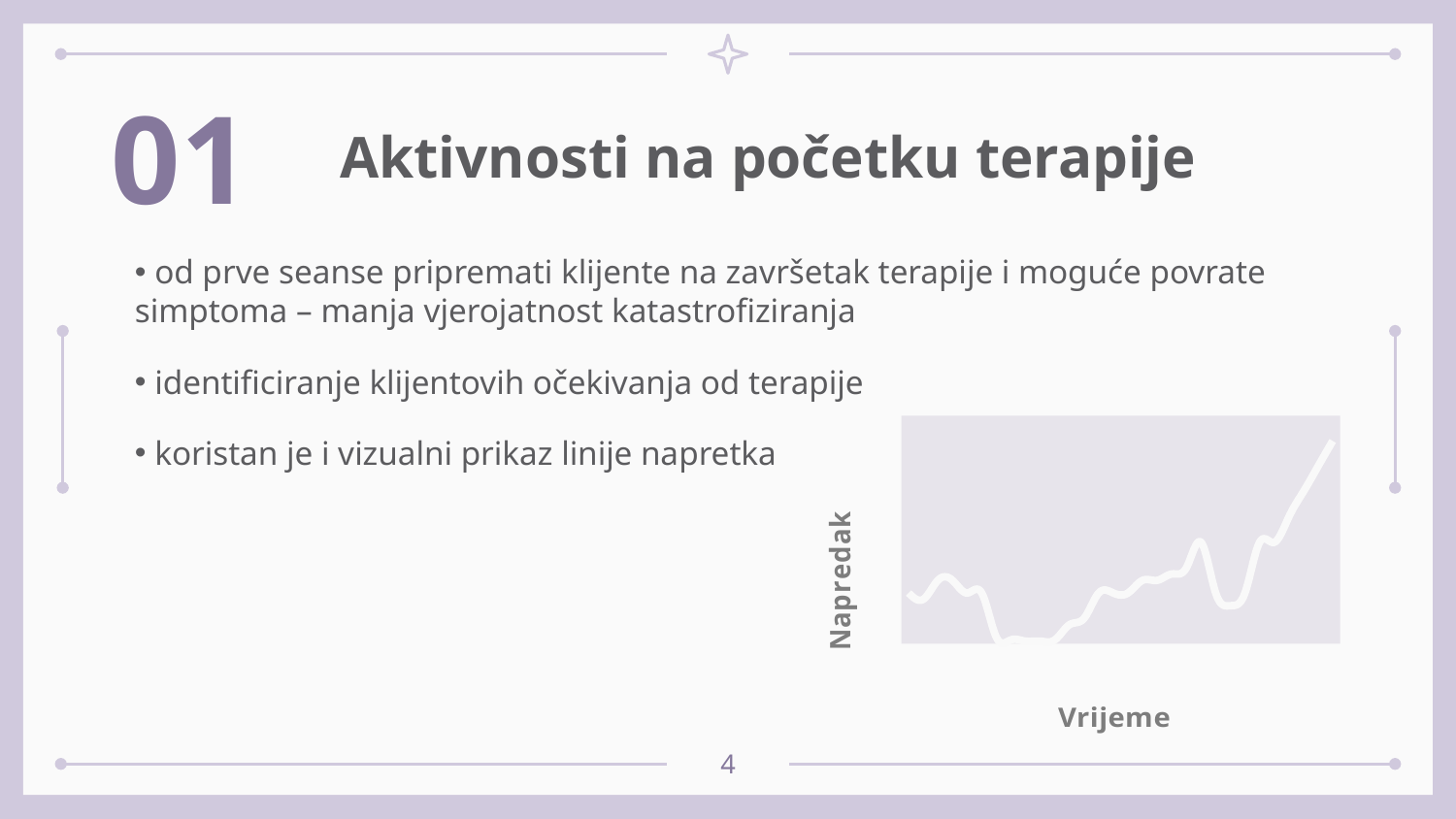
What kind of chart is shown on the slide? line chart Overall, does the line in the chart rise or fall from left to right along the x axis? rise What is the label on the horizontal axis of the chart? Vrijeme Is the value at the right end of the line higher or lower than the value at the left end? higher What is the label on the vertical axis of the chart? Napredak